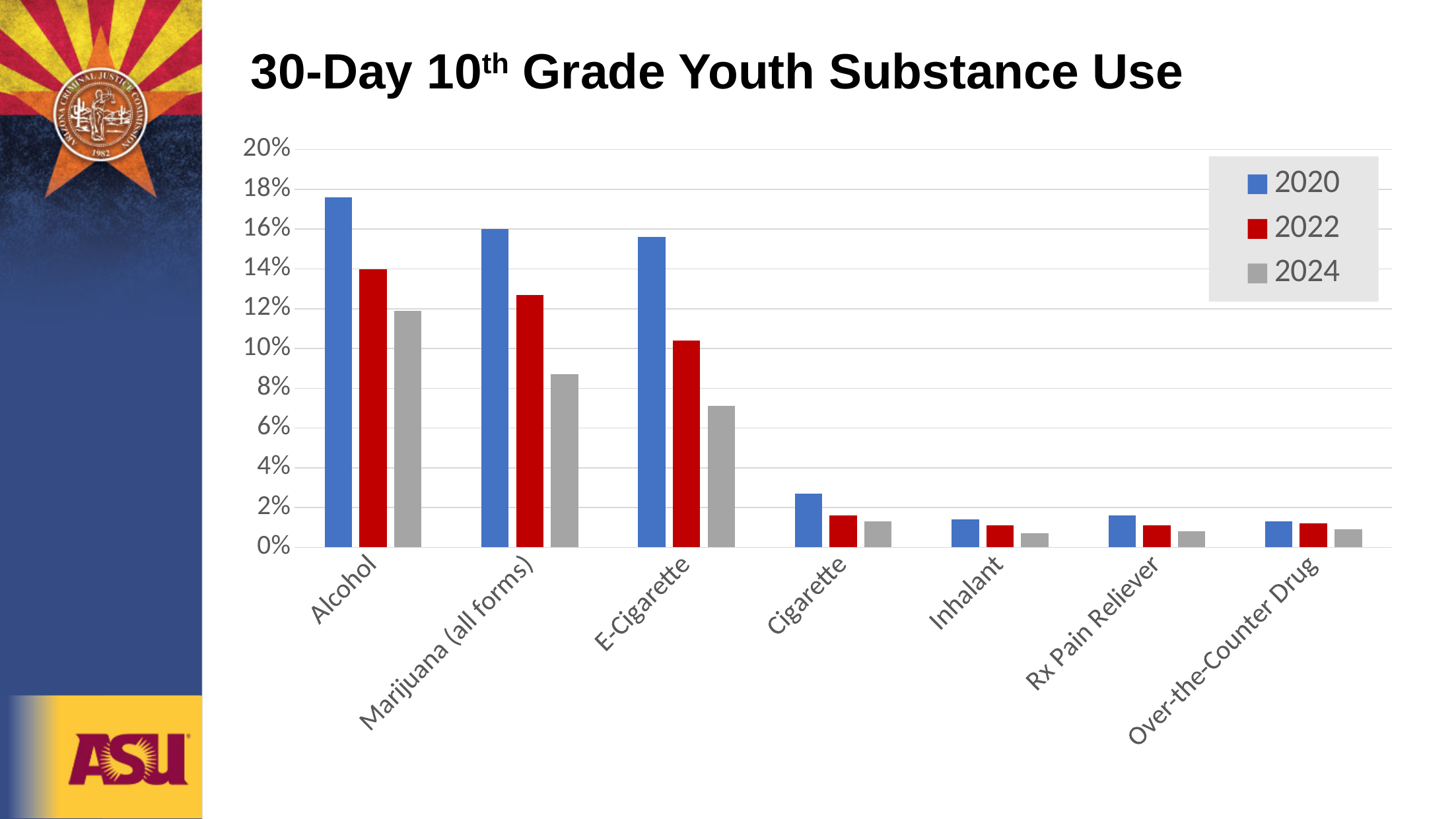
What kind of chart is shown on the slide? bar chart How many series does the legend list? 3 Is the 2024 value for E-Cigarette greater or less than 8%? less What is the title of the chart? 30-Day 10th Grade Youth Substance Use Is the 2020 value for Cigarette greater or less than 2%? greater Is the 2024 value for Marijuana (all forms) greater or less than 10%? less Which substance has the highest value for 2020? Alcohol Which is larger for 2022: Marijuana (all forms) or E-Cigarette? Marijuana (all forms) Do the values for Alcohol rise or fall from 2020 to 2024? fall How many substance categories are shown on the x axis? 7 Which year is shown in red in the legend? 2022